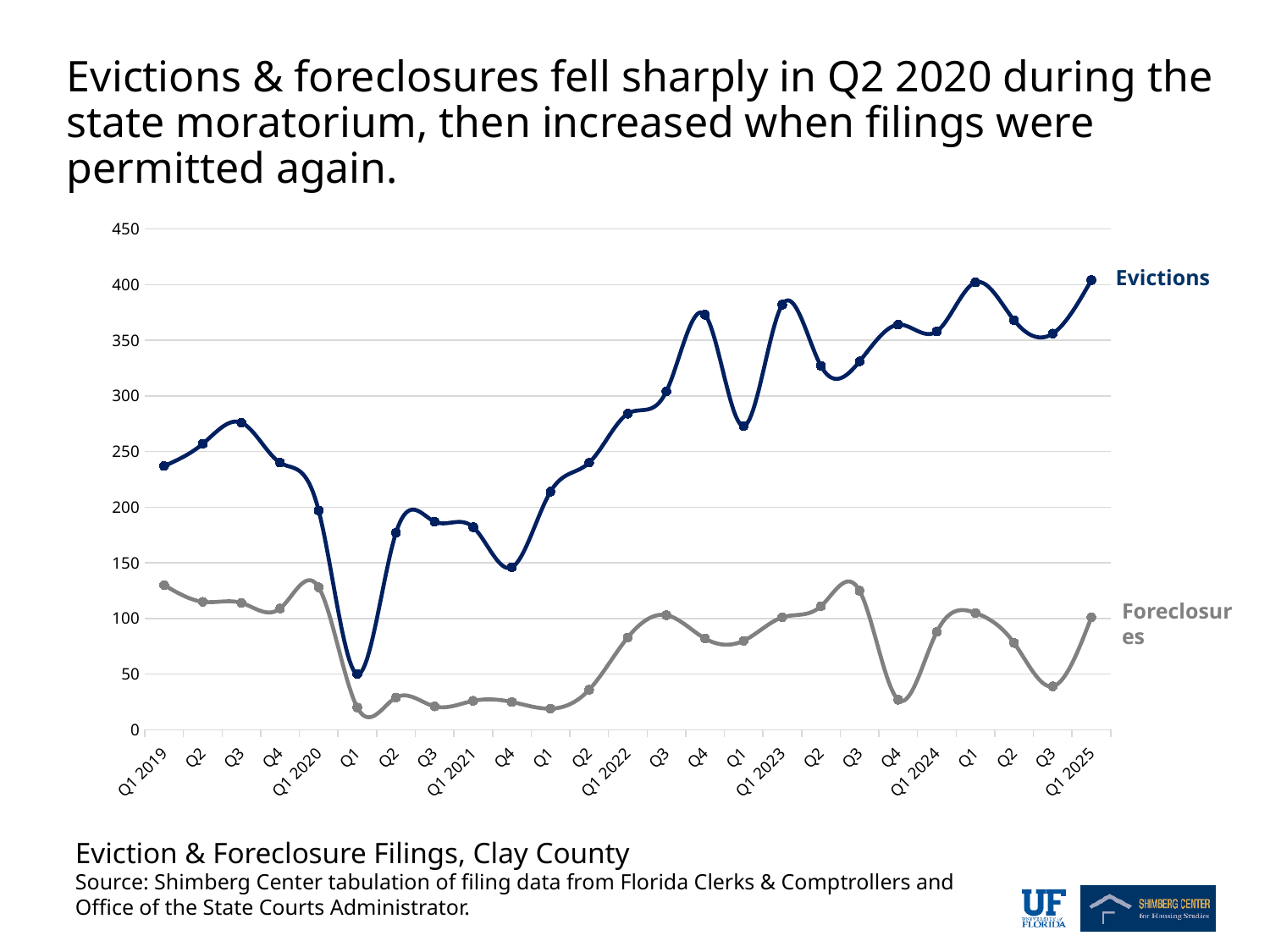
At Q1 2025, which series has the higher value, Evictions or Foreclosures? Evictions Is the Evictions value for Q2 2020 greater or less than 100? less What is the title of the chart, as given below it? Eviction & Foreclosure Filings, Clay County Overall, does the Evictions line rise or fall from Q1 2019 to Q1 2025? rise In which quarter does the Evictions line reach its lowest value? Q2 2020 What kind of chart is shown on the slide? Line chart How many series does the chart plot? 2 How many quarterly data points does each line have on the x axis? 25 Is the Evictions value for Q1 2019 greater or less than 200? greater Is the Foreclosures value for Q1 2025 greater or less than 150? less What are the names of the two series plotted on the chart? Evictions and Foreclosures